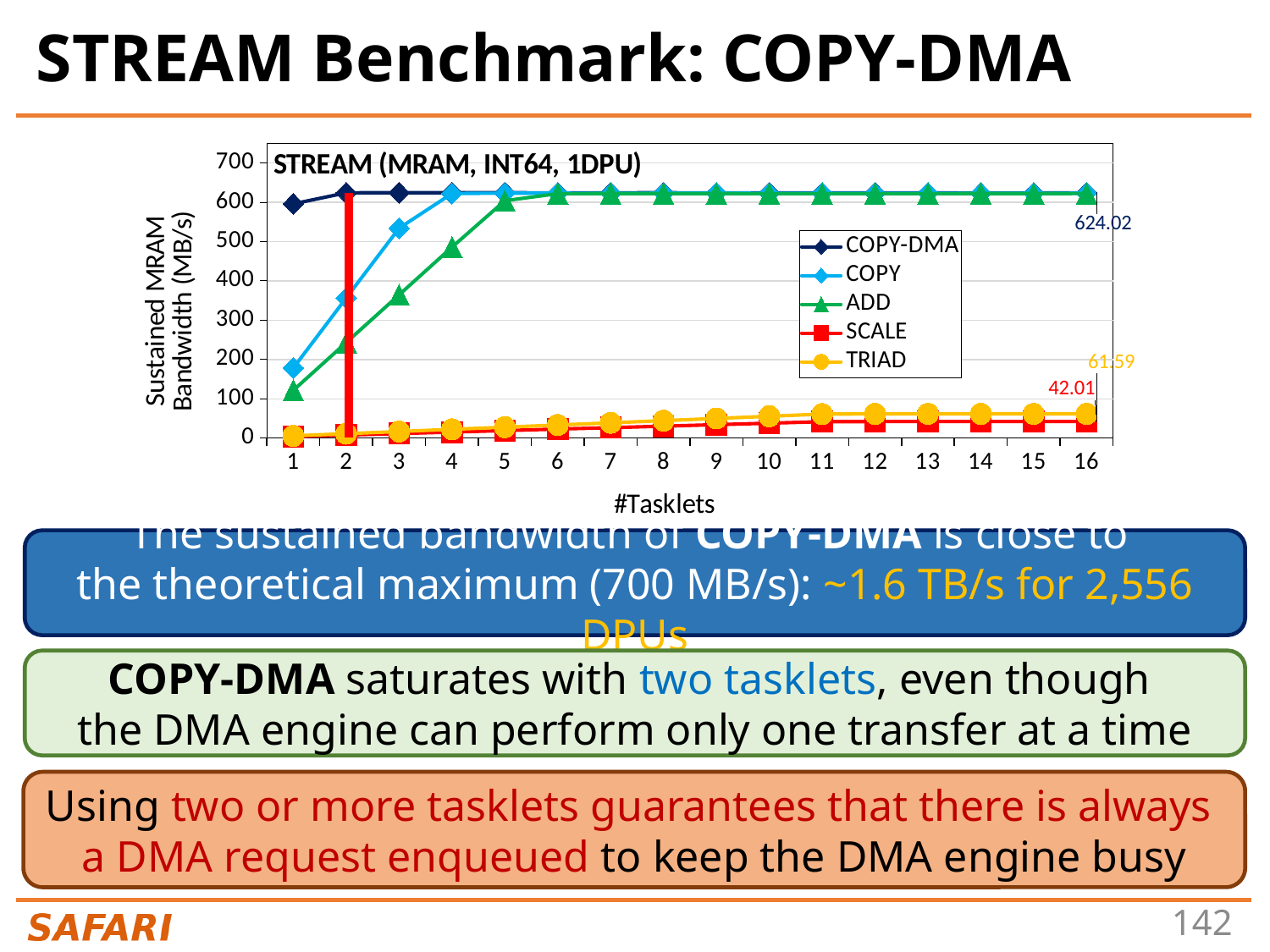
Is the value for ADD at 2 tasklets greater or less than 300? less Which series has the lowest value at 16 tasklets? SCALE Which series has the highest value at 1 tasklet? COPY-DMA What kind of chart is shown on the slide? Line chart Is the value for COPY-DMA at 1 tasklet greater or less than 500? greater How many series does the legend list? 5 At 16 tasklets, which series has the larger labeled value, TRIAD or SCALE? TRIAD What is the labeled value of SCALE at 16 tasklets? 42.01 What is the labeled value of TRIAD at 16 tasklets? 61.59 What is the labeled value of COPY-DMA at 16 tasklets? 624.02 How many tasklet counts are shown on the x axis? 16 What is the difference between the labeled COPY-DMA value (624.02) and the labeled SCALE value (42.01) at 16 tasklets? 582.01